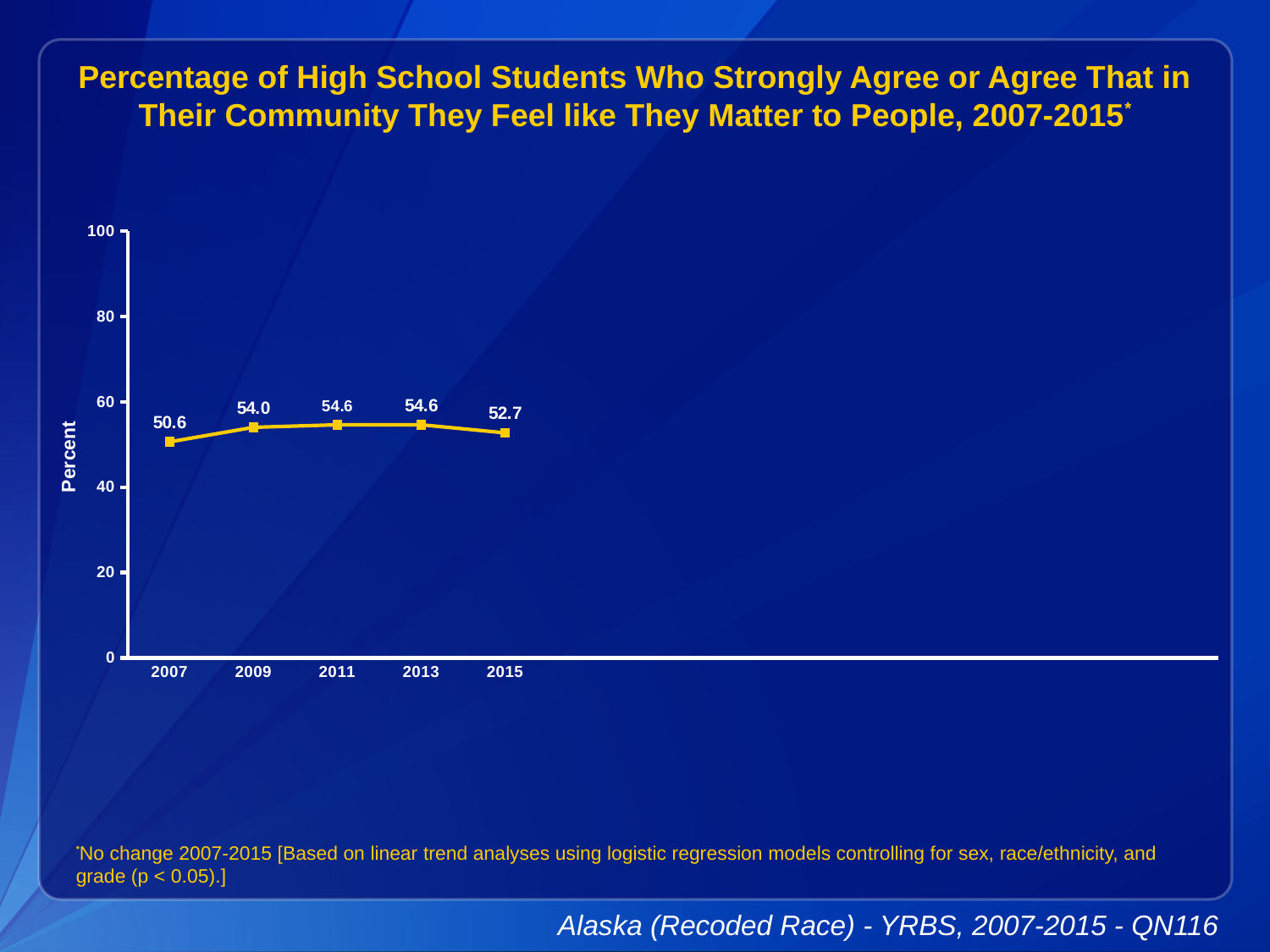
What is the difference between the values for 2011 and 2007? 4.0 How many years are plotted on the chart? 5 What kind of chart is shown on the slide? line chart What is the label on the y axis? Percent Does the value rise or fall from 2007 to 2011? rise Which year has the lowest value? 2007 Which is larger, the value for 2009 or the value for 2015? 2009 What is the value for 2009? 54.0 What is the value for 2007? 50.6 What is the difference between the values for 2013 and 2015? 1.9 What is the value for 2015? 52.7 Is the value for 2013 greater or less than 60? less